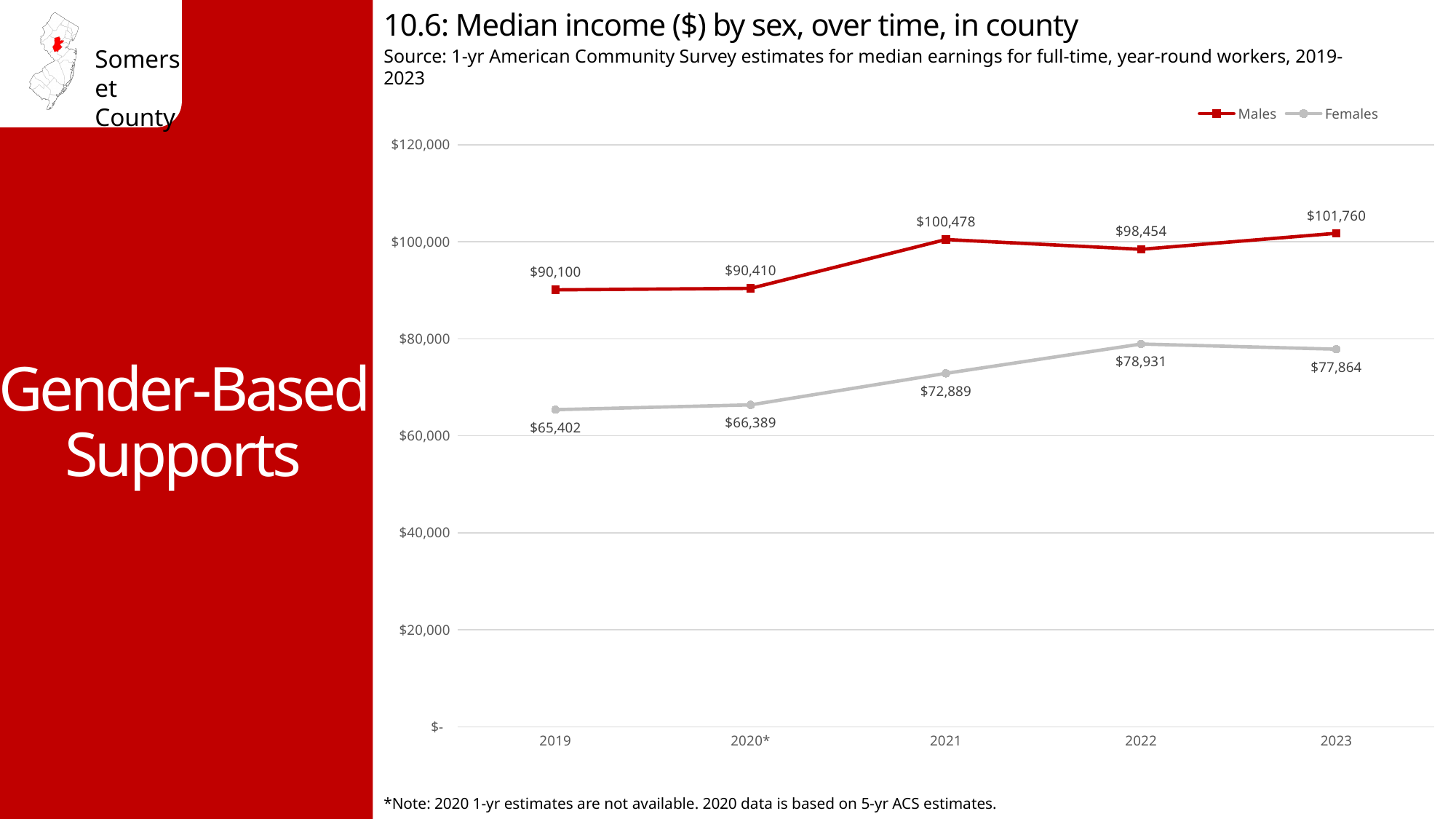
In which year was the median income for Females lowest? 2019 Did the median income for Females rise or fall from 2019 to 2022? rise What was the median income for Females in 2019? $65,402 What is the difference between the Males and Females median income in 2023? $23,896 Is the median income for Females in 2021 greater or less than $80,000? less What was the median income for Males in 2021? $100,478 What kind of chart is shown on the slide? line chart What was the median income for Females in 2022? $78,931 How many series does the legend list? 2 In which year was the median income for Males highest? 2023 Which was larger in 2022: the median income for Males or for Females? Males How many years are shown on the x axis? 5